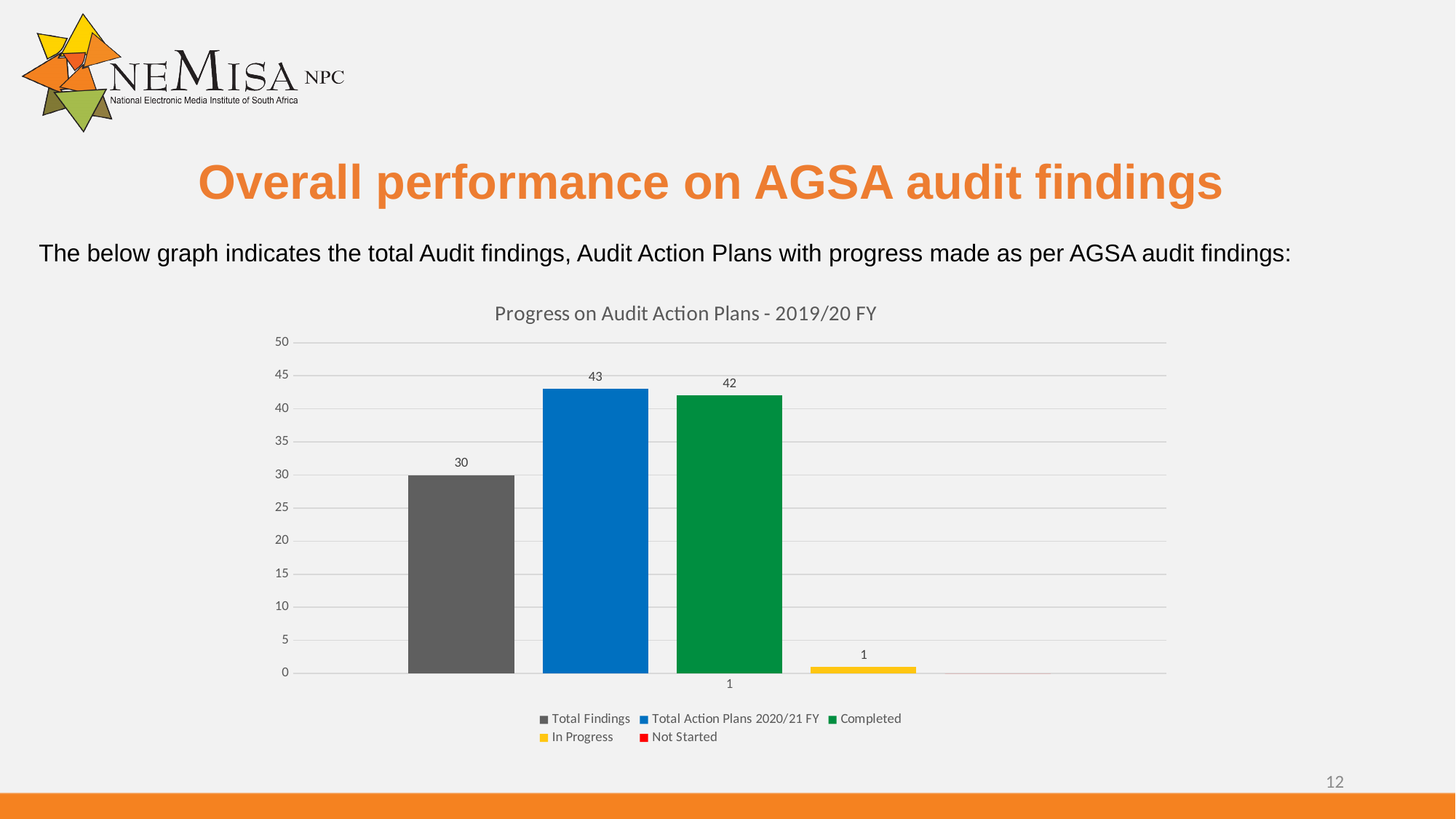
What is the value for Total Findings in the Progress on Audit Action Plans - 2019/20 FY chart? 30 What is the value for Total Action Plans 2020/21 FY? 43 What is the difference between Total Action Plans 2020/21 FY and Completed? 1 What is the difference between Total Action Plans 2020/21 FY and Total Findings? 13 What is the title of the chart? Progress on Audit Action Plans - 2019/20 FY What is the value for In Progress? 1 Which series has the highest value in the chart? Total Action Plans 2020/21 FY What kind of chart is shown on the slide? bar chart Is the value for Total Findings greater or less than 35? less What is the value for Completed? 42 How many series does the legend list? 5 Which is larger, Total Findings or Completed? Completed